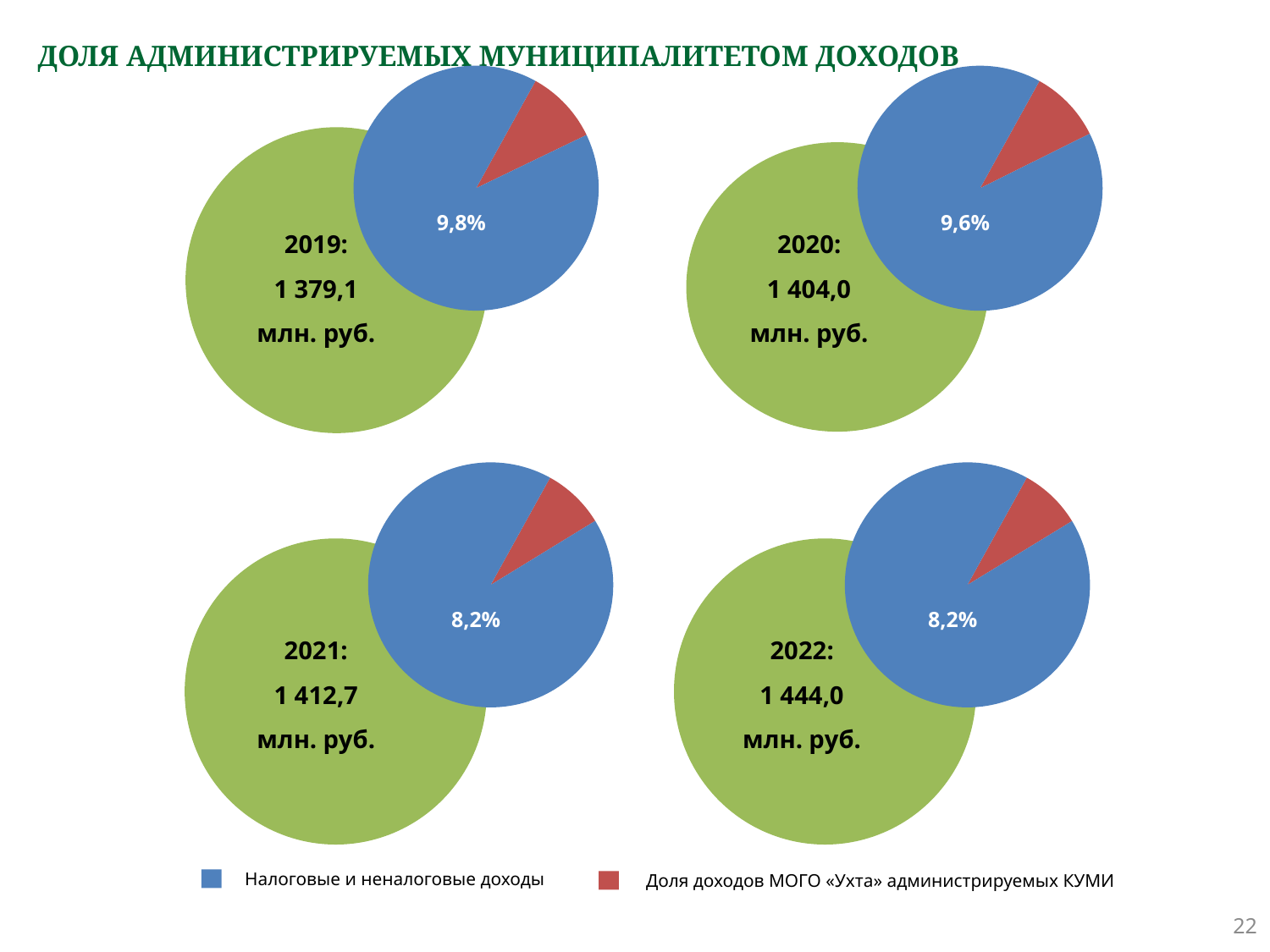
What total revenue amount (млн. руб.) is shown next to the 2022 pie chart? 1 444,0 What total revenue amount (млн. руб.) is shown next to the 2019 pie chart? 1 379,1 What percentage is labelled on the 2019 pie chart? 9,8% What kind of chart is used on this slide? Pie chart How many entries does the legend list? 2 What is the difference between the percentages labelled on the 2019 and 2020 pie charts? 0,2% Which year's pie chart shows the highest labelled percentage? 2019 Do the total revenue amounts shown next to the pie charts rise or fall from 2019 to 2022? Rise What percentage is labelled on the 2021 pie chart? 8,2% Which is larger: the total revenue shown for 2020 or for 2021? 2021 How many pie charts are on the slide? 4 What percentage is labelled on the 2020 pie chart? 9,6%